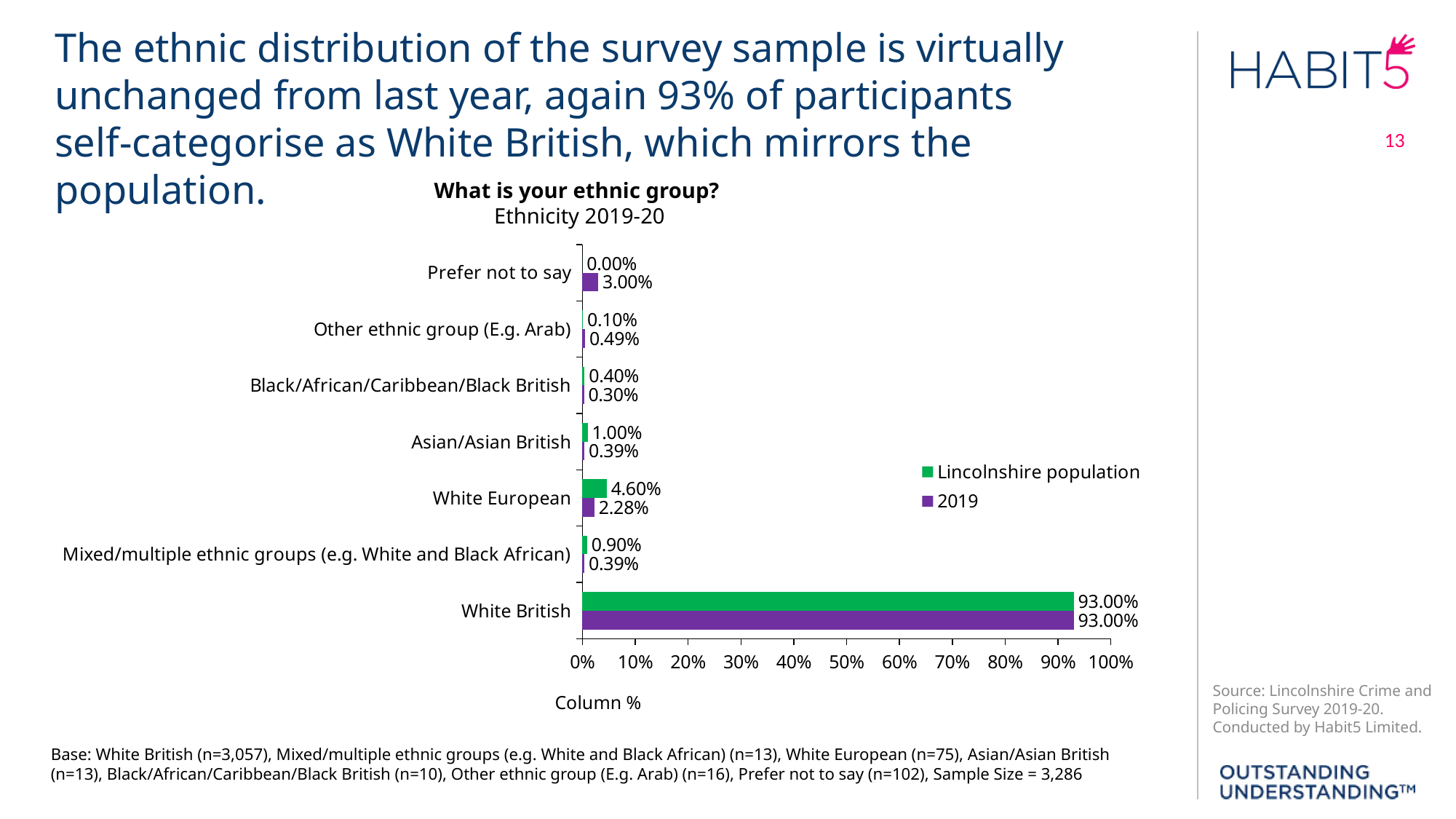
Which category has the highest 2019 value? White British What is the Lincolnshire population value for Asian/Asian British? 1.00% Is the 2019 value for White British greater or less than 90%? greater What is the 2019 value for Prefer not to say? 3.00% What is the 2019 value for White European? 2.28% What kind of chart is shown on the slide? Bar chart What is the Lincolnshire population value for Mixed/multiple ethnic groups (e.g. White and Black African)? 0.90% What is the difference between the Lincolnshire population and 2019 values for White European? 2.32% How many ethnic group categories are shown on the chart? 7 For Other ethnic group (E.g. Arab), which is larger: the Lincolnshire population value or the 2019 value? 2019 Which category has the lowest Lincolnshire population value? Prefer not to say How many series does the legend list? 2